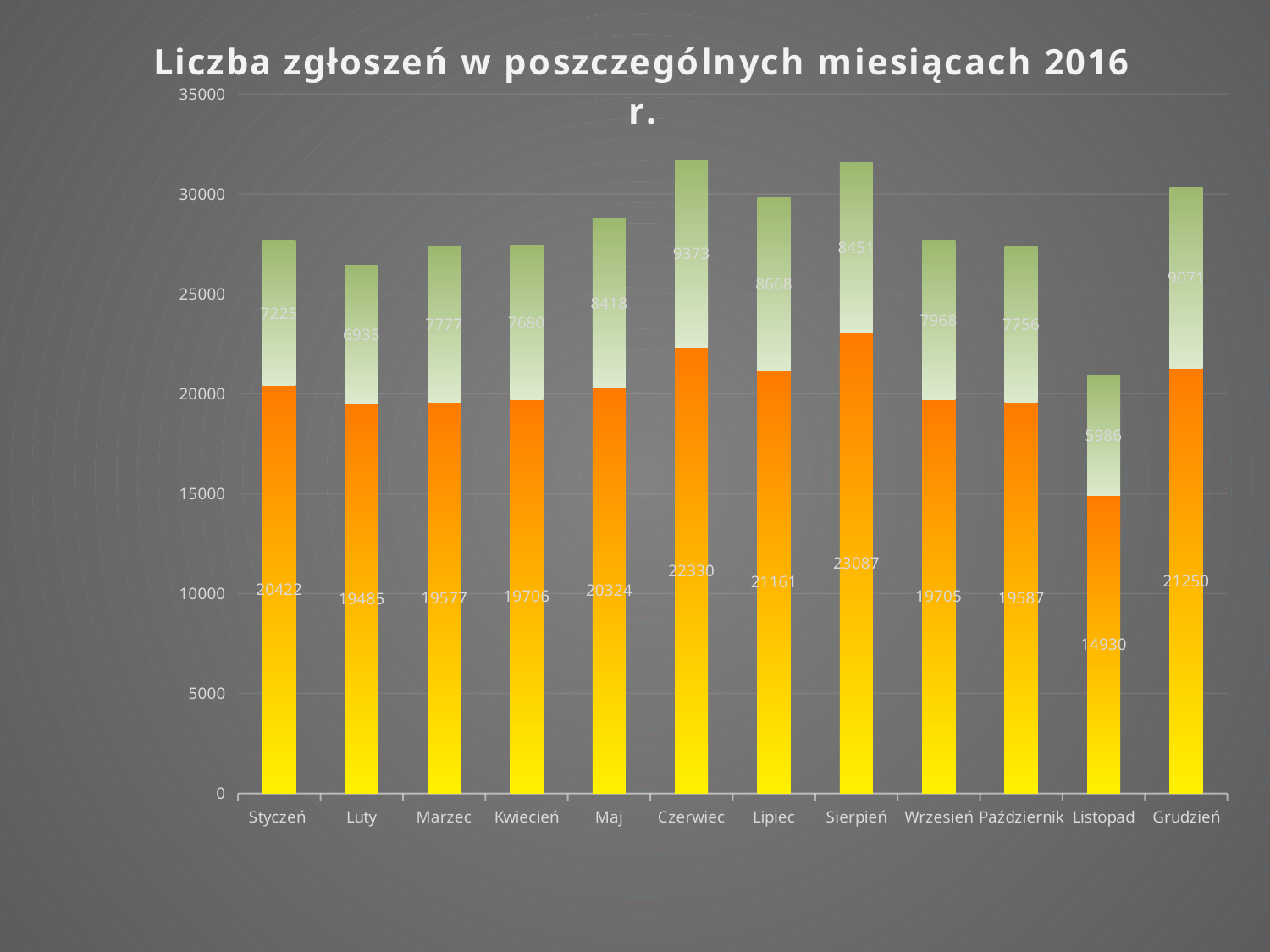
What kind of chart is shown on the slide? Stacked bar chart What is the value of the green (upper) segment for Grudzień? 9071 Is the total height of the bar for Listopad greater or less than 25000? less What is the title of the chart? Liczba zgłoszeń w poszczególnych miesiącach 2016 r. What is the difference between the orange (lower) segment values for Czerwiec and Lipiec? 1169 What is the total of the stacked bar for Listopad? 20916 Which month has the larger green (upper) segment, Maj or Wrzesień? Maj Which month has the lowest value in the orange (lower) segment? Listopad What is the value of the orange (lower) segment for Sierpień? 23087 Which month has the highest value in the orange (lower) segment? Sierpień What is the value of the green (upper) segment for Luty? 6935 How many months are shown on the x axis of the chart? 12